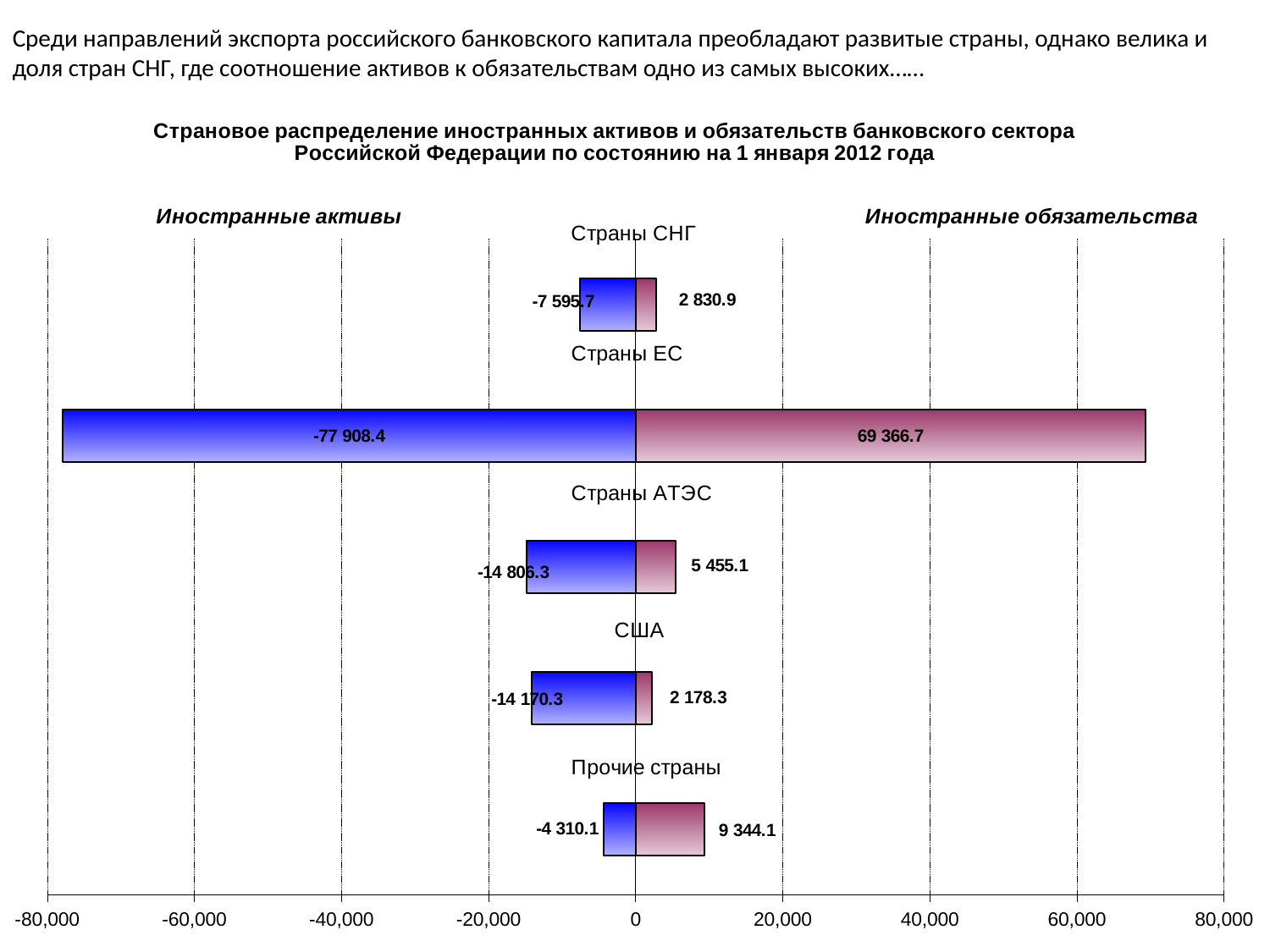
What is the value of Иностранные активы for Страны АТЭС? -14 806.3 What is the value of Иностранные обязательства for Прочие страны? 9 344.1 Which category has the highest value of Иностранные обязательства? Страны ЕС What is the date stated in the chart title? 1 января 2012 года What kind of chart is shown on the slide? bar chart Which is larger in absolute terms for Прочие страны: Иностранные активы or Иностранные обязательства? Иностранные обязательства What is the value of Иностранные активы for США? -14 170.3 What is the difference between the Иностранные обязательства values for Страны АТЭС and США? 3 276.8 Is the value of Иностранные обязательства for Страны ЕС greater or less than 60,000? greater How many categories are shown on the chart? 5 What is the value of Иностранные обязательства for Страны ЕС? 69 366.7 Which category has the lowest value of Иностранные обязательства? США